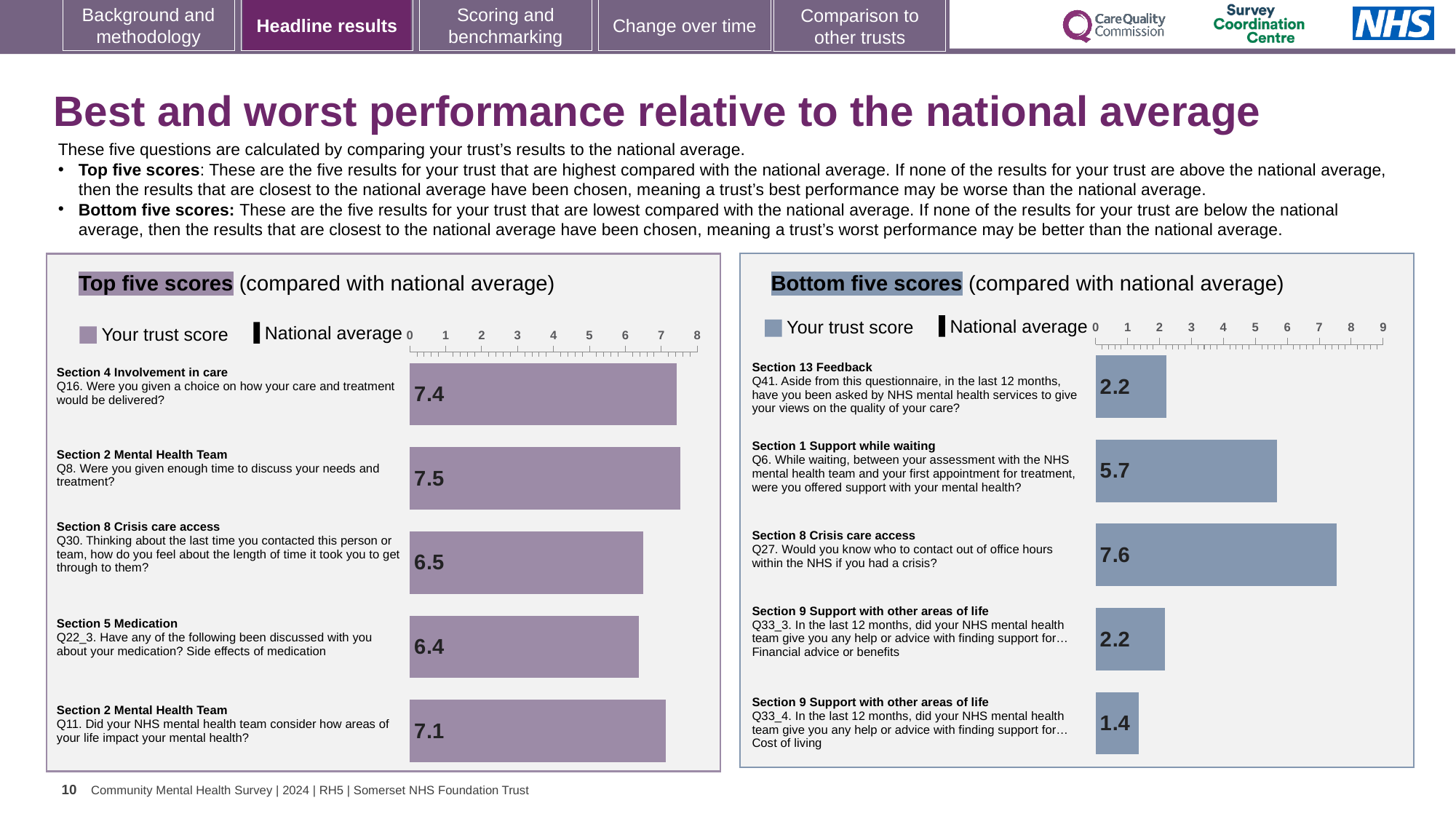
In the Top five scores chart, what is the difference between the trust scores for Q8 and Q22_3? 1.1 In the Top five scores chart, which question has the lowest trust score? Q22_3 In the Bottom five scores chart, what is the difference between the trust scores for Q27 and Q33_4? 6.2 In the Top five scores chart, how many questions are plotted? 5 How many series does the legend of the Bottom five scores chart list? 2 In the Top five scores chart, which question has the highest trust score? Q8 In the Bottom five scores chart, which question has the lowest trust score? Q33_4 In the Bottom five scores chart, what is the trust score for Q6 (support while waiting)? 5.7 In the Bottom five scores chart, which question has the highest trust score? Q27 In the Bottom five scores chart, is the trust score for Q6 larger or smaller than the trust score for Q41? larger In the Top five scores chart, what is the trust score for Q16 (choice on how care and treatment would be delivered)? 7.4 What kind of chart is the Top five scores chart? bar chart